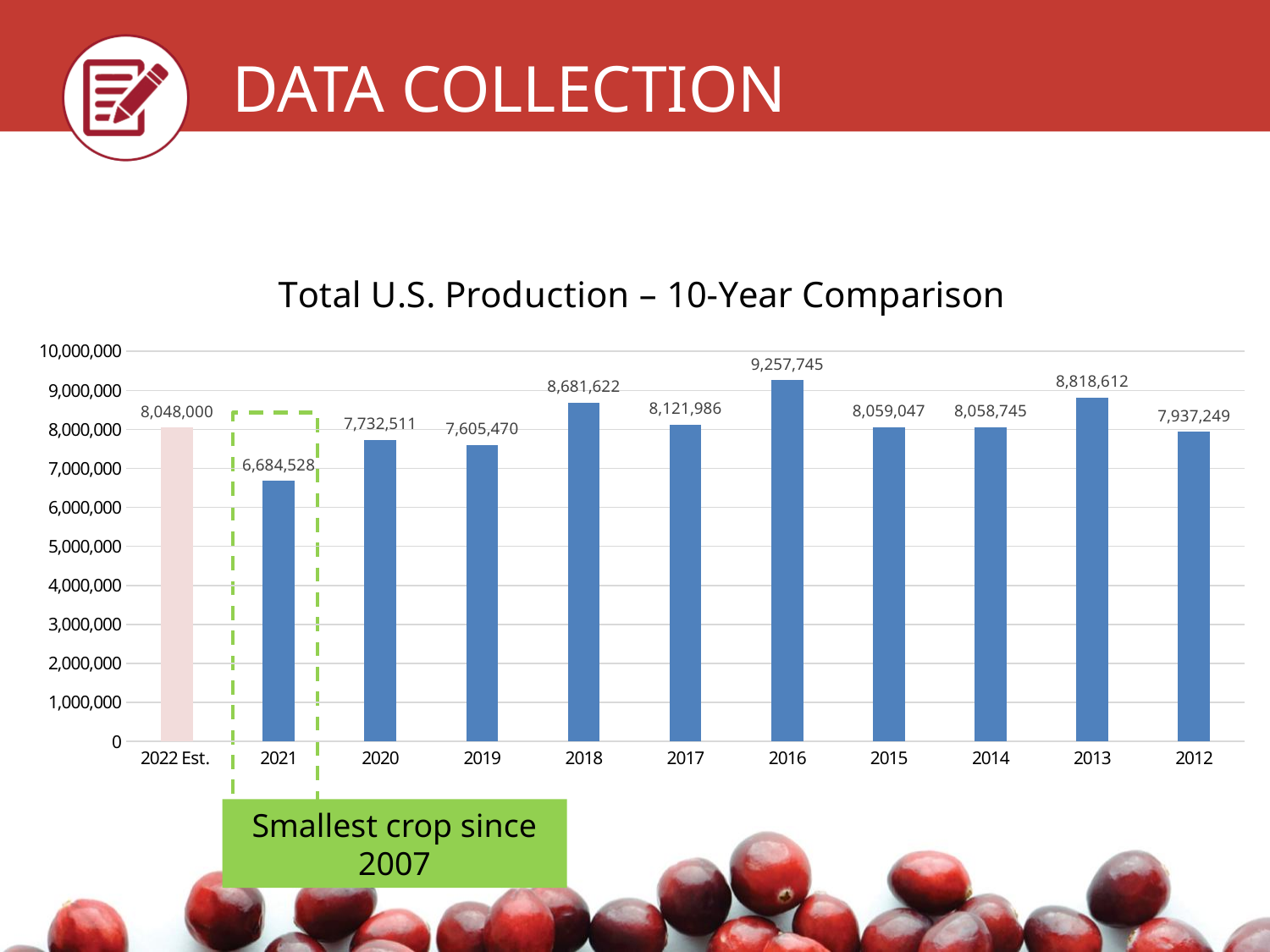
Is the value for 2021 greater or less than 7,000,000? less How many years are shown on the x axis? 11 What is the value for 2022 Est.? 8,048,000 What is the difference between the 2018 value and the 2017 value? 559,636 What is the value for 2013? 8,818,612 What is the value for 2021? 6,684,528 What is the difference between the 2016 value and the 2021 value? 2,573,217 Which is larger, the value for 2013 or the value for 2018? 2013 What kind of chart is shown? bar chart Which year has the highest production? 2016 What is the title of the chart? Total U.S. Production – 10-Year Comparison Which year has the lowest production? 2021